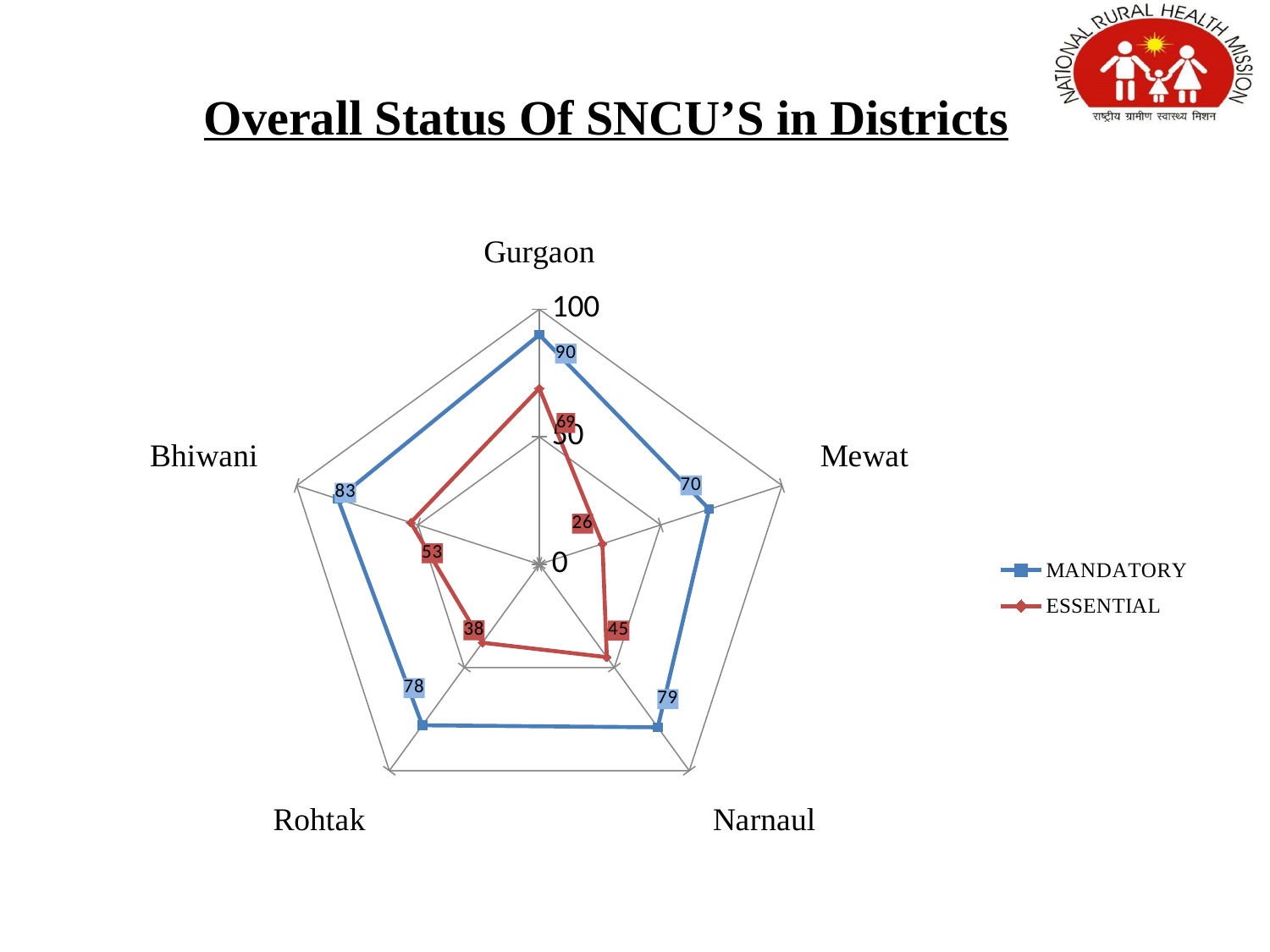
Is the ESSENTIAL value for Gurgaon greater or less than 50? greater Which district has the lowest MANDATORY value? Mewat What is the difference between the MANDATORY and ESSENTIAL values for Bhiwani? 30 How many series does the legend list? 2 Which district has the highest MANDATORY value? Gurgaon What is the ESSENTIAL value for Rohtak? 38 How many districts are plotted on the chart? 5 What kind of chart is shown on the slide? Radar chart Which is larger, the MANDATORY value for Narnaul or the MANDATORY value for Mewat? Narnaul What is the MANDATORY value for Gurgaon? 90 What is the ESSENTIAL value for Mewat? 26 Which district has the lowest ESSENTIAL value? Mewat